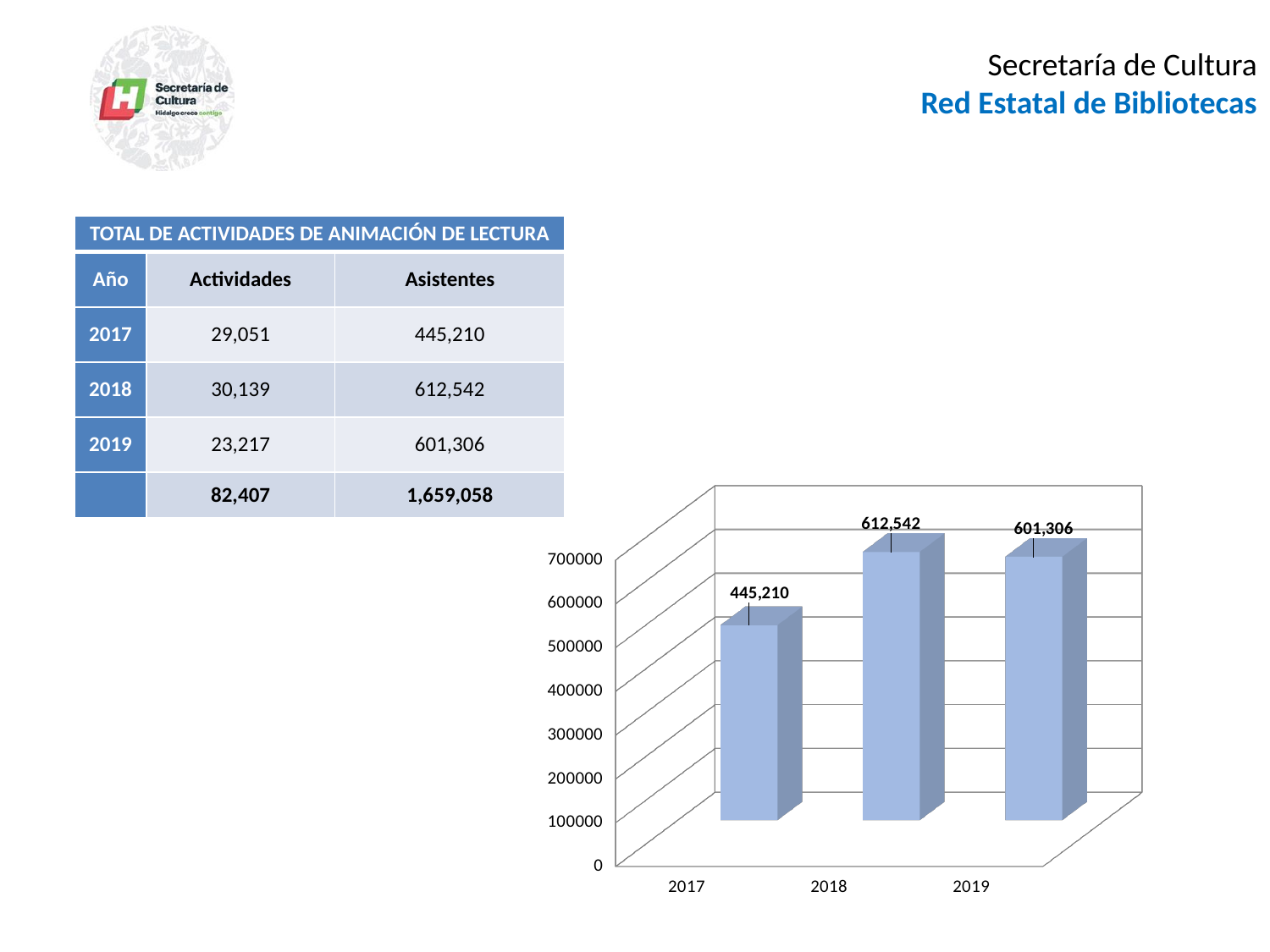
Which year has the lowest bar in the chart? 2017 How many bars are plotted in the chart? 3 Is the value for 2017 in the bar chart greater or less than 500000? less What kind of chart is shown on the slide? bar chart What value is shown for 2019 in the bar chart? 601,306 What value is shown for 2018 in the bar chart? 612,542 What value is shown for 2017 in the bar chart? 445,210 What is the difference between the values for 2018 and 2019 in the bar chart? 11,236 Does the value rise or fall from 2017 to 2018 in the bar chart? rise What is the difference between the values for 2018 and 2017 in the bar chart? 167,332 Which year has the highest bar in the chart? 2018 Which is larger in the bar chart, the value for 2019 or the value for 2017? 2019